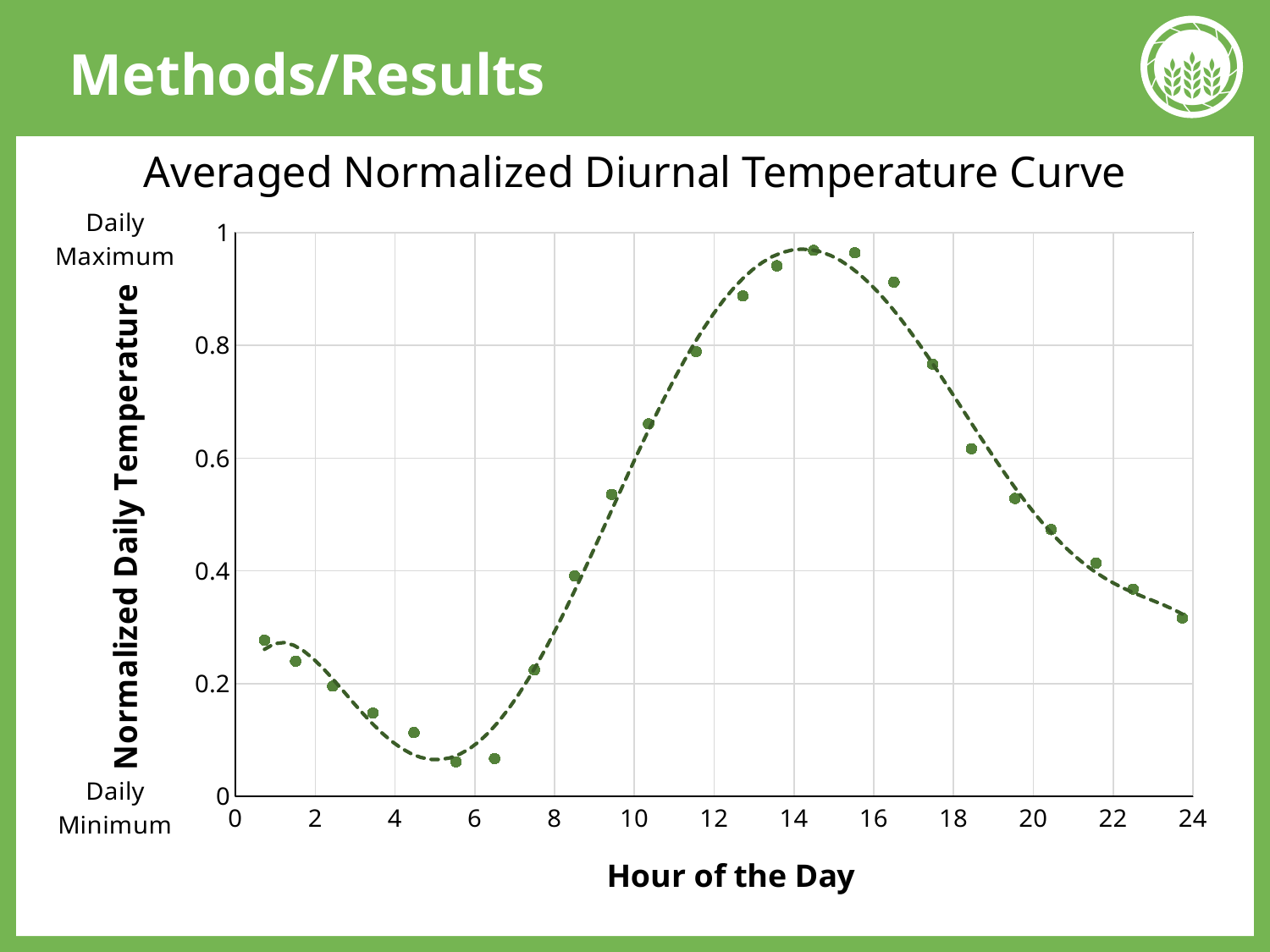
Do the values rise or fall along the x axis between hour 16 and hour 24? fall What kind of chart is shown on the slide? scatter chart Is the value for the point near hour 5.5 greater or less than 0.2? less Is the value for the point near hour 20.5 greater or less than 0.6? less How many data points are plotted on the chart? 24 Which point has the larger value: the one near hour 10.5 or the one near hour 20.5? the one near hour 10.5 Is the value for the point near hour 10.5 greater or less than 0.4? greater What is the title of the chart? Averaged Normalized Diurnal Temperature Curve What is the x-axis title of the chart? Hour of the Day Do the values rise or fall along the x axis between hour 6 and hour 14? rise Which point has the larger value: the one near hour 12.5 or the one near hour 2.5? the one near hour 12.5